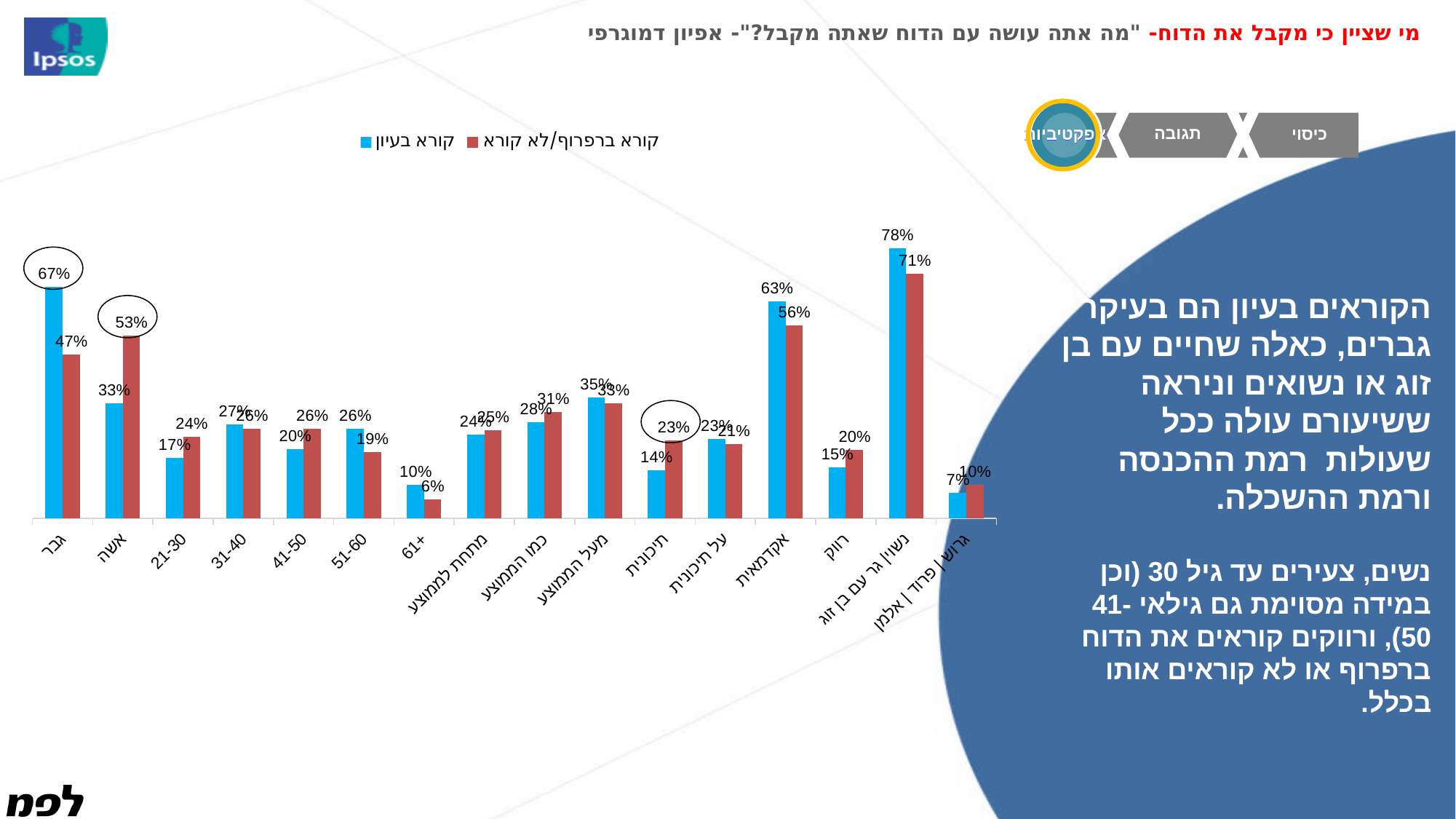
Which category has the highest value for קורא בעיון? נשוי/גר עם בן זוג How many categories are shown on the x axis of the chart? 16 For תיכונית, which series has the larger value: קורא בעיון or קורא ברפרוף/לא קורא? קורא ברפרוף/לא קורא What is the value of קורא בעיון for אקדמאית? 63% What is the value of קורא ברפרוף/לא קורא for נשוי/גר עם בן זוג? 71% What is the value of קורא בעיון for גבר? 67% What is the difference between the קורא בעיון and קורא ברפרוף/לא קורא values for גבר? 20% What is the value of קורא ברפרוף/לא קורא for אשה? 53% Which category has the lowest value for קורא ברפרוף/לא קורא? 61+ What kind of chart is shown on the slide? bar chart How many series does the legend list? 2 Which colour represents the series קורא בעיון in the legend? blue